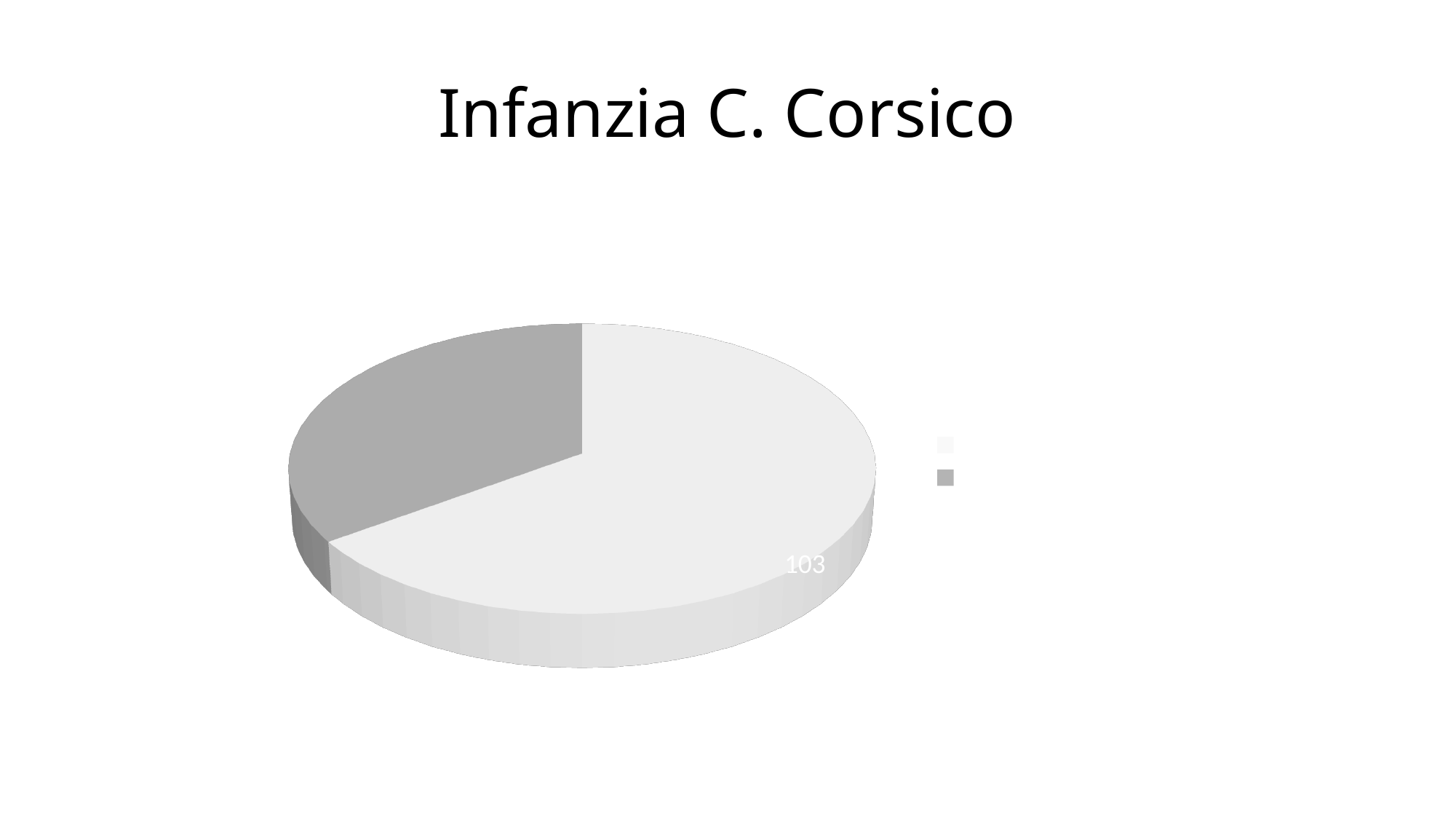
What kind of chart is shown on the slide? pie chart How many slices does the pie chart have? 2 Is the light grey slice larger or smaller than the dark grey slice? larger Does the light grey slice take up more or less than half of the pie? more What value is printed on the large light grey slice of the pie? 103 Which slice is the smallest in the pie chart, the light grey one or the dark grey one? the dark grey slice Is the value of the light grey slice greater or less than 100? greater Which slice is the largest in the pie chart, the light grey one or the dark grey one? the light grey slice How many entries does the legend list? 2 What is the title of the chart? Infanzia C. Corsico